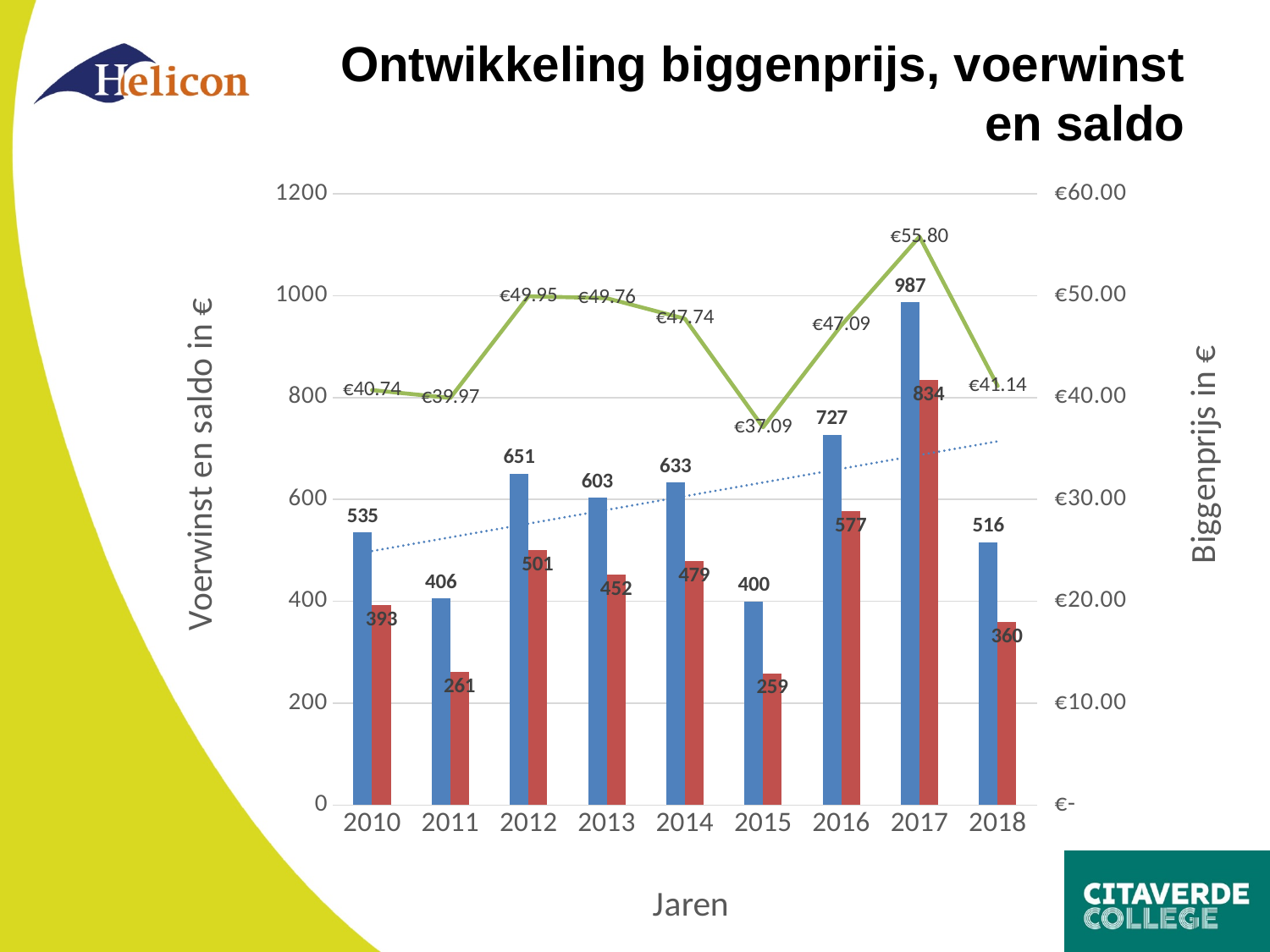
In which year is the blue bar highest? 2017 Do the blue bars rise or fall from 2015 to 2017? Rise Which year has the larger blue bar, 2012 or 2014? 2012 In which year does the green line (biggenprijs) reach its highest value? 2017 What is the value of the blue bar for 2017? 987 How many years are shown on the x axis? 9 What is the value of the red bar for 2011? 261 What is the difference between the blue bar and the red bar in 2017? 153 What kind of chart is this? Bar chart with a line In which year is the green line (biggenprijs) at its lowest value? 2015 What is the title of the x axis? Jaren What is the value of the green line (biggenprijs) for 2015? €37.09